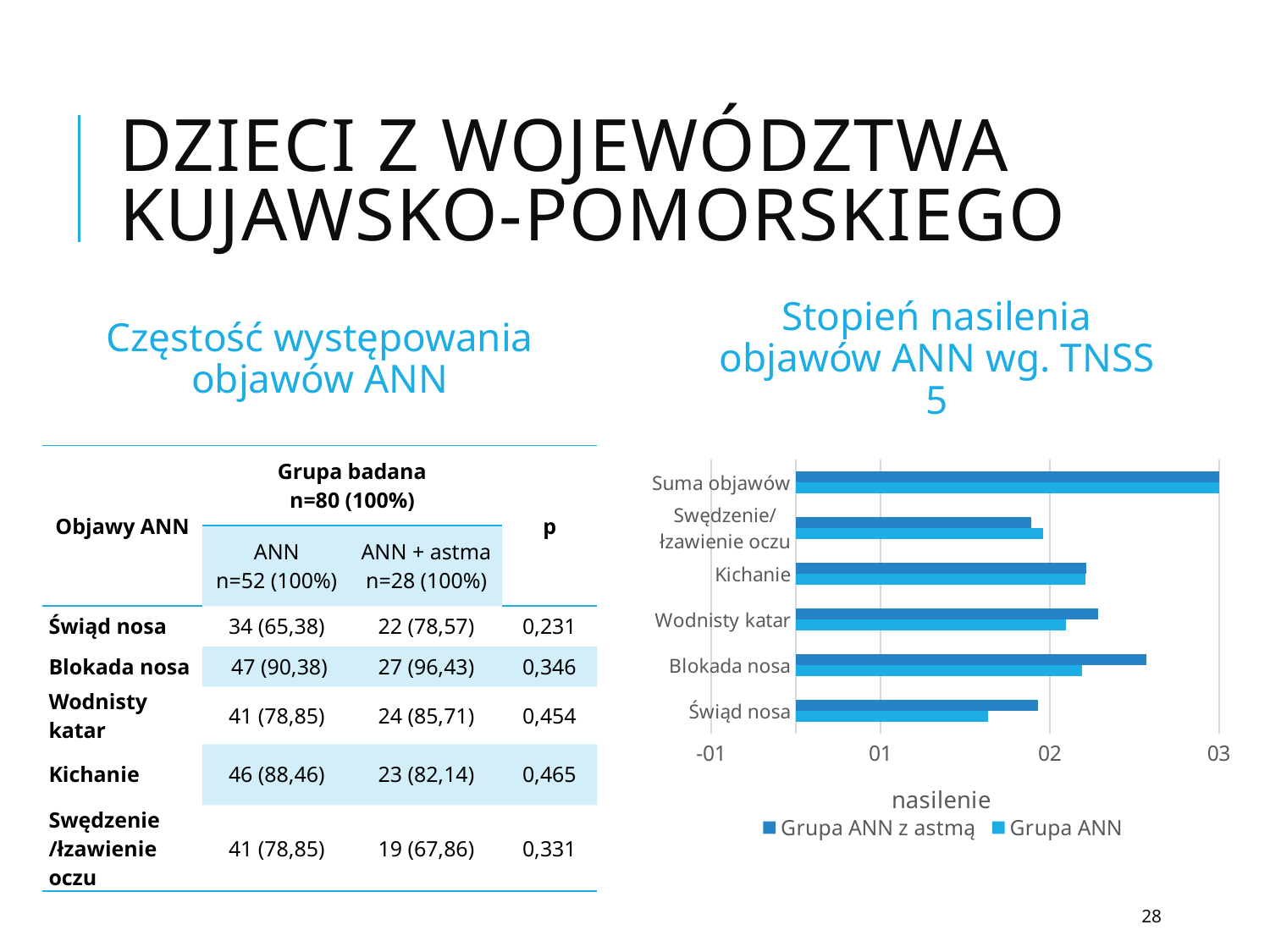
In the "Stopień nasilenia objawów ANN wg. TNSS 5" chart, is the value of Kichanie for Grupa ANN greater or less than 01? greater In the "Stopień nasilenia objawów ANN wg. TNSS 5" chart, which category has the lowest value for Grupa ANN? Świąd nosa How many categories are plotted on the y axis of the "Stopień nasilenia objawów ANN wg. TNSS 5" chart? 6 In the "Stopień nasilenia objawów ANN wg. TNSS 5" chart, for Blokada nosa, which series has the larger value: Grupa ANN z astmą or Grupa ANN? Grupa ANN z astmą What is the x-axis title of the "Stopień nasilenia objawów ANN wg. TNSS 5" chart? nasilenie In the "Stopień nasilenia objawów ANN wg. TNSS 5" chart, which category has the highest value for Grupa ANN z astmą? Suma objawów How many series does the legend of the "Stopień nasilenia objawów ANN wg. TNSS 5" chart list? 2 What kind of chart is shown under the title "Stopień nasilenia objawów ANN wg. TNSS 5"? Bar chart In the "Stopień nasilenia objawów ANN wg. TNSS 5" chart, is the value of Świąd nosa for Grupa ANN greater or less than 02? less Which series in the "Stopień nasilenia objawów ANN wg. TNSS 5" chart is drawn in the darker blue? Grupa ANN z astmą In the "Stopień nasilenia objawów ANN wg. TNSS 5" chart, for Świąd nosa, which series has the larger value: Grupa ANN z astmą or Grupa ANN? Grupa ANN z astmą In the "Stopień nasilenia objawów ANN wg. TNSS 5" chart, is the value of Suma objawów for Grupa ANN z astmą greater or less than 02? greater